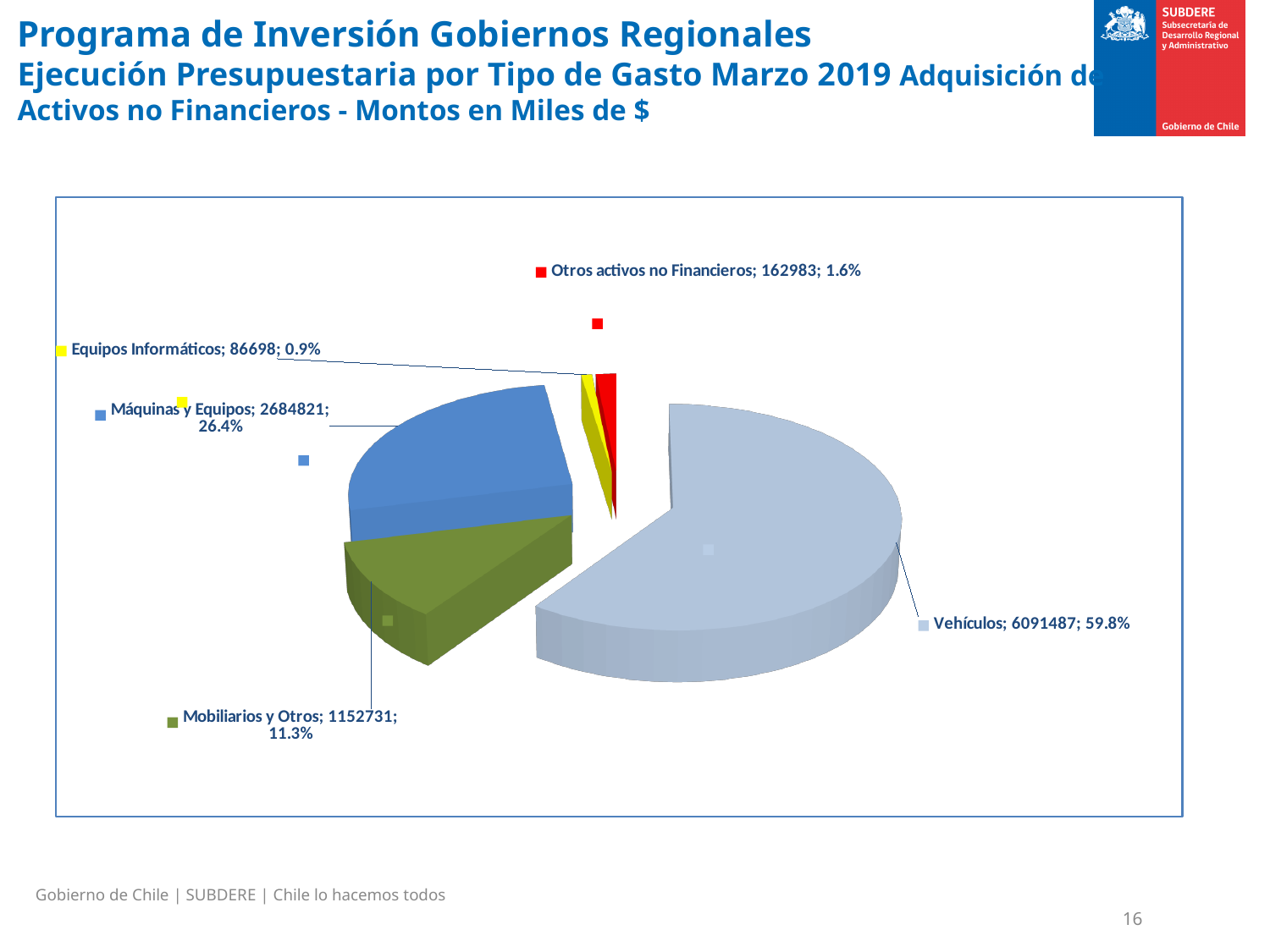
What is the value for Vehículos? 6091487 What is the value for Mobiliarios y Otros? 1152731 How many slices does the pie chart have? 5 What is the difference between the values for Vehículos and Máquinas y Equipos? 3406666 What share of the pie does Equipos Informáticos represent? 0.9% Which category has the smallest slice of the pie? Equipos Informáticos Which category has the largest slice of the pie? Vehículos What colour is the slice for Vehículos? Light blue What is the value for Otros activos no Financieros? 162983 What kind of chart is shown on the slide? Pie chart Which is larger, the value for Mobiliarios y Otros or the value for Otros activos no Financieros? Mobiliarios y Otros What share of the pie does Máquinas y Equipos represent? 26.4%